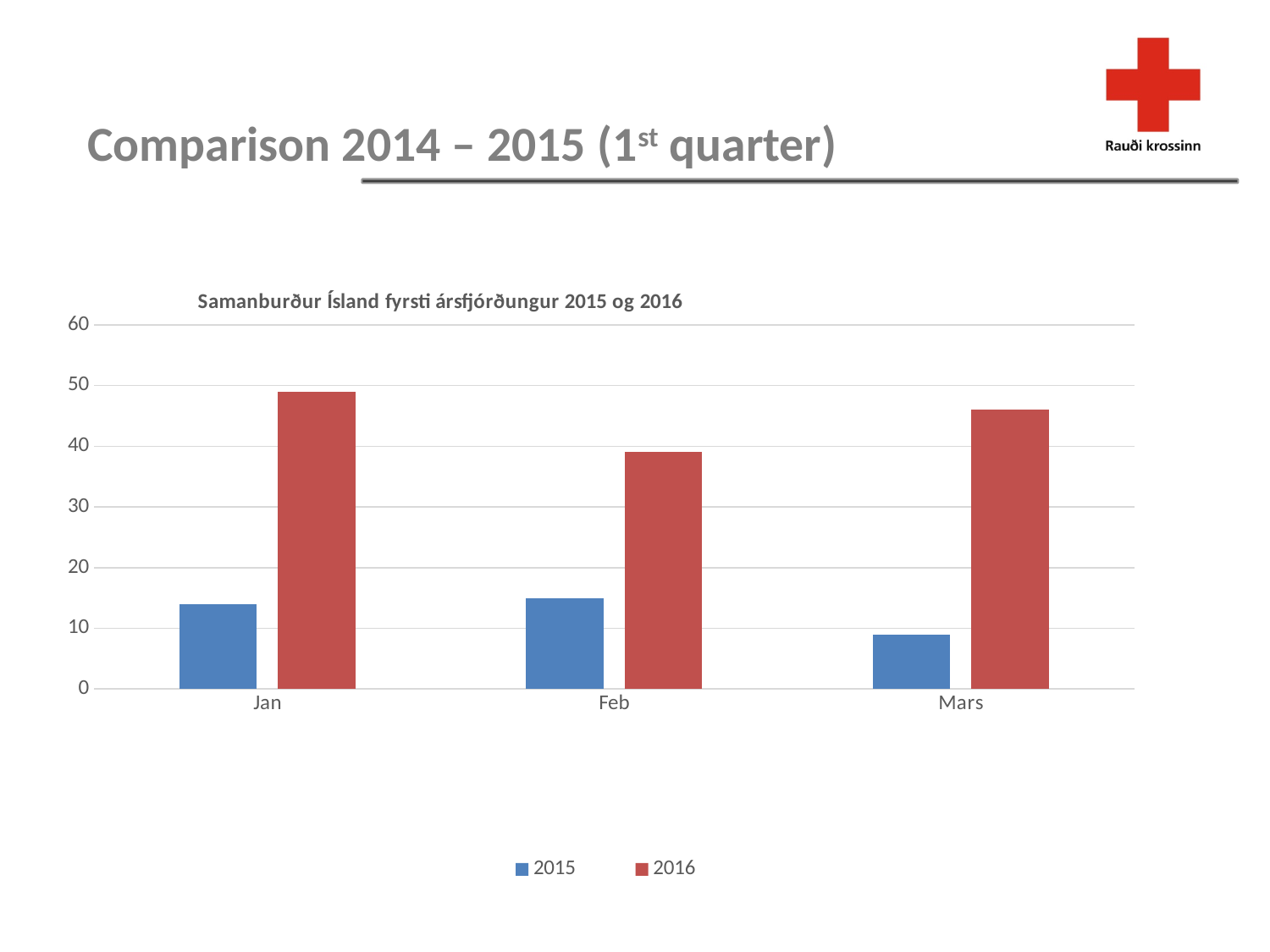
Which is larger for Jan: the 2015 value or the 2016 value? 2016 Which month has the lowest value for the 2015 series? Mars Is the value for Jan in the 2015 series greater or less than 20? less Is the value for Feb in the 2016 series greater or less than 30? greater In the 2016 series, which is larger: the value for Feb or the value for Mars? Mars What kind of chart is shown on the slide? bar chart What is the title of the chart? Samanburður Ísland fyrsti ársfjórðungur 2015 og 2016 Is the value for Mars in the 2016 series greater or less than 40? greater How many months are shown on the x axis of the chart? 3 How many series does the chart legend list? 2 Which month has the lowest value for the 2016 series? Feb